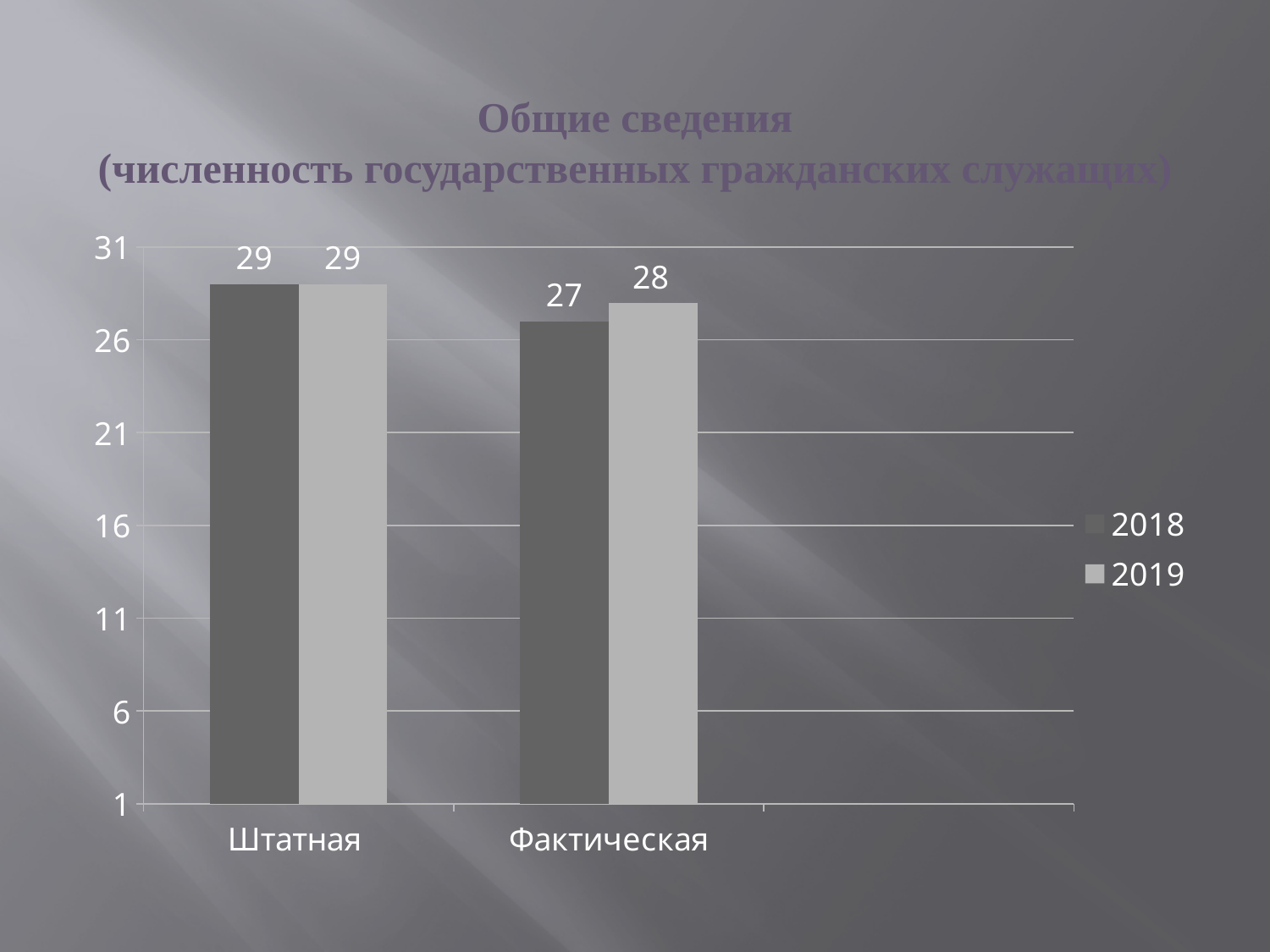
What is the value for Фактическая in 2018? 27 Which series is shown in the lighter grey colour? 2019 What is the value for Штатная in 2018? 29 What is the difference between Штатная and Фактическая in 2018? 2 What kind of chart is shown on the slide? bar chart Which category has the lowest value in 2018? Фактическая What is the difference between the 2019 and 2018 values for Фактическая? 1 Which is larger for Фактическая: the 2018 value or the 2019 value? 2019 How many series does the legend list? 2 What is the value for Фактическая in 2019? 28 What is the value for Штатная in 2019? 29 How many categories are shown on the x axis? 2